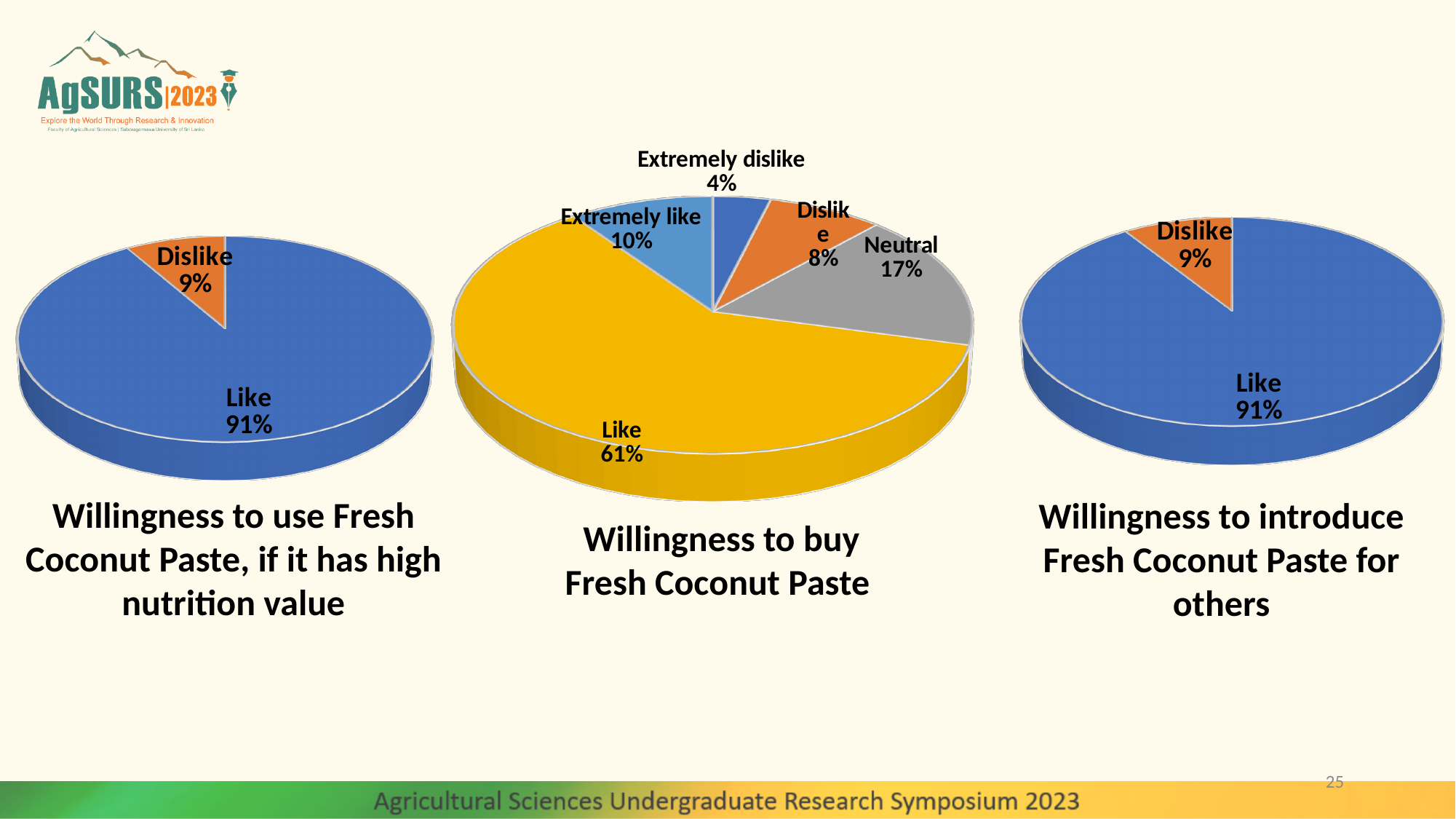
In the 'Willingness to buy Fresh Coconut Paste' chart, what share of respondents answered Extremely dislike? 4% What kind of chart is used for 'Willingness to introduce Fresh Coconut Paste for others'? Pie chart In the 'Willingness to buy Fresh Coconut Paste' chart, what is the difference between the Neutral and Extremely like shares? 7% In the 'Willingness to buy Fresh Coconut Paste' chart, which category has the largest share? Like In the 'Willingness to buy Fresh Coconut Paste' chart, what share of respondents answered Like? 61% In the 'Willingness to buy Fresh Coconut Paste' chart, how many categories are shown? 5 In the 'Willingness to buy Fresh Coconut Paste' chart, which category has the smallest share? Extremely dislike How many pie charts are shown on the slide? 3 In the 'Willingness to introduce Fresh Coconut Paste for others' chart, what share answered Like? 91% In the 'Willingness to use Fresh Coconut Paste, if it has high nutrition value' chart, what share answered Dislike? 9% In the 'Willingness to buy Fresh Coconut Paste' chart, which is larger, Dislike or Extremely like? Extremely like In the 'Willingness to buy Fresh Coconut Paste' chart, what share of respondents answered Neutral? 17%